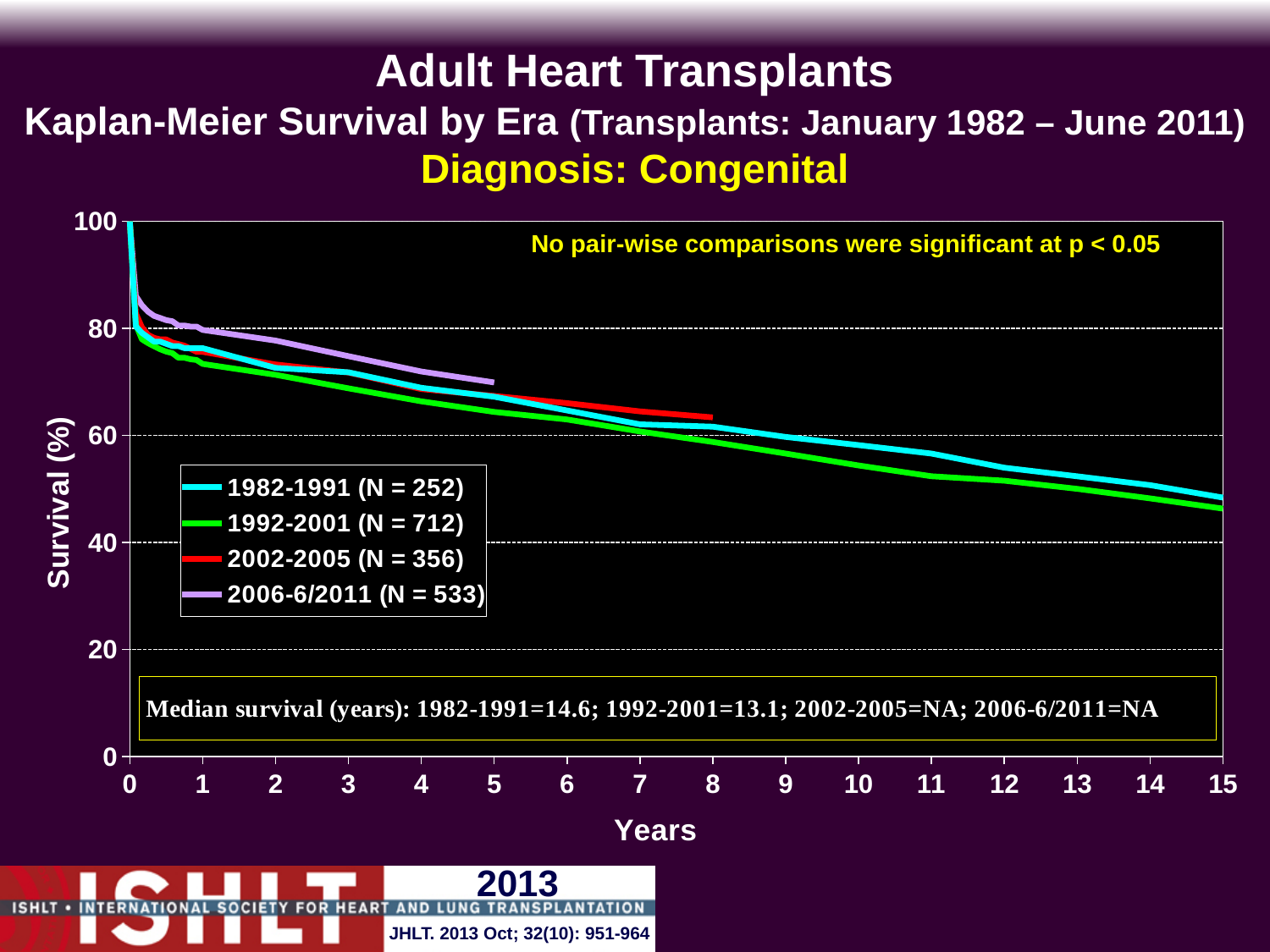
What kind of chart is shown on the slide? line chart What is the median survival in years for the 1992-2001 era? 13.1 Is the survival for the 1982-1991 era at 15 years greater or less than 60? less What is the median survival reported for the 2002-2005 era? NA Which era has the largest number of transplants (N) in the legend? 1992-2001 (N = 712) What is the median survival in years for the 1982-1991 era? 14.6 Do the survival curves rise or fall as years since transplant increase? fall At 15 years, which era has the lowest survival? 1992-2001 Is the survival for the 1992-2001 era at 15 years greater or less than 40? greater How many eras (series) does the legend list? 4 At 5 years, which era has the highest survival? 2006-6/2011 Is the survival for the 2006-6/2011 era at 5 years greater or less than 60? greater